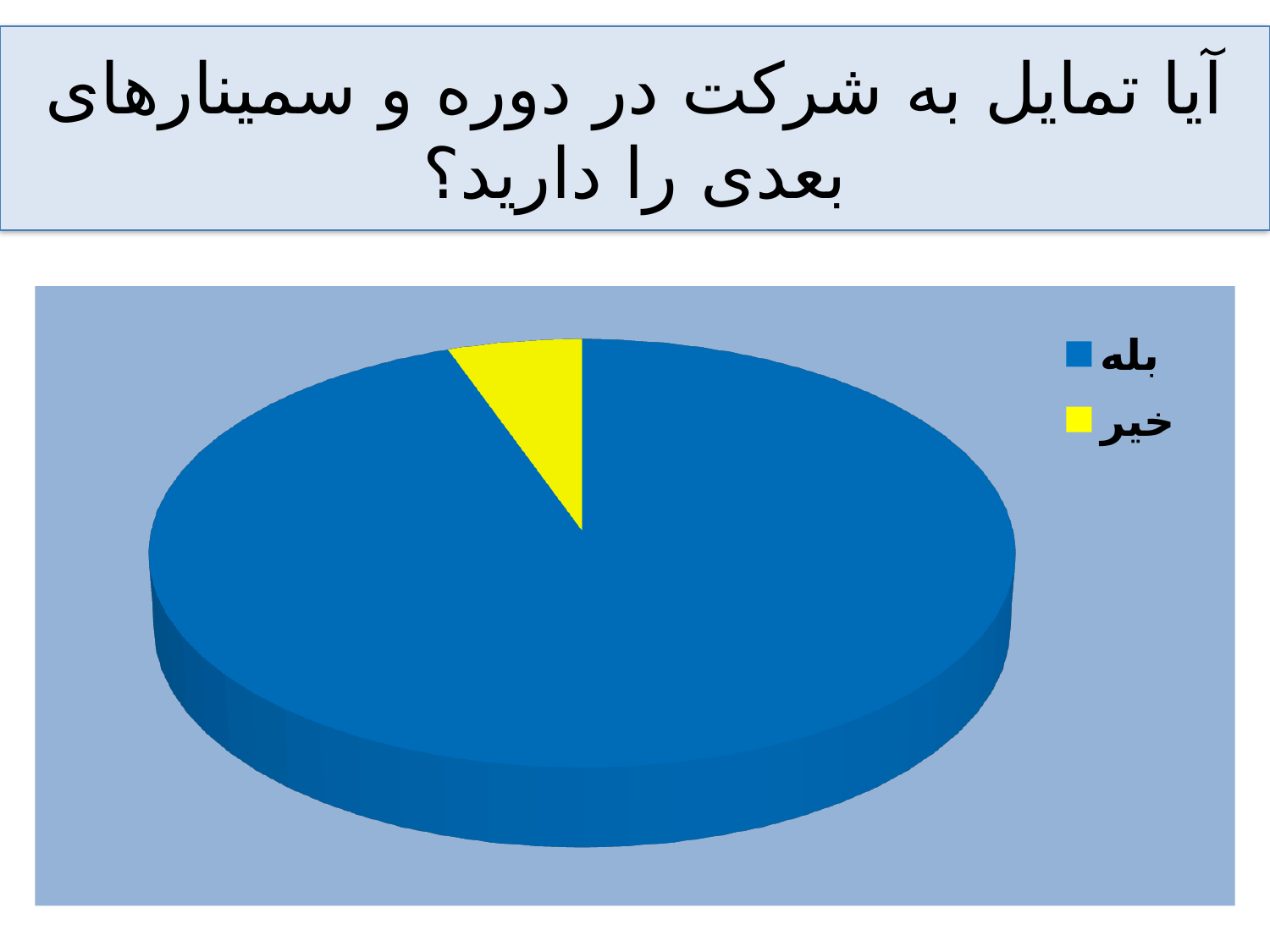
How many entries does the legend list? 2 Which category has the smallest slice of the pie? خیر What colour is the slice for خیر? yellow How many slices does the pie chart have? 2 What kind of chart is shown on the slide? pie chart Which slice is larger, بله or خیر? بله Which category has the largest slice of the pie? بله What colour is the slice for بله? blue